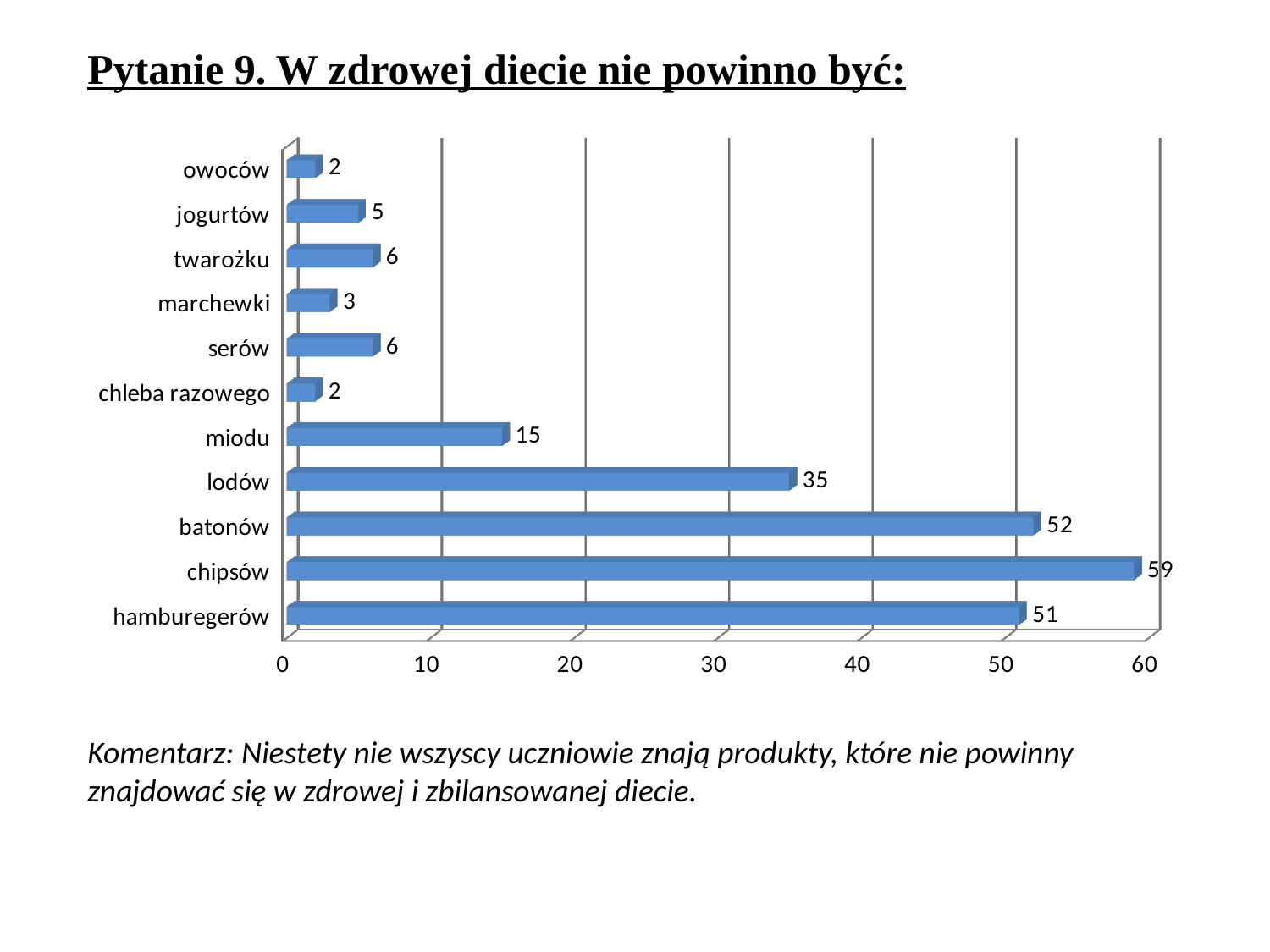
What is the difference between the values for batonów and hamburegerów? 1 Which is larger, the value for jogurtów or the value for marchewki? jogurtów What is the value for lodów? 35 What is the title of the slide above the chart? Pytanie 9. W zdrowej diecie nie powinno być: What kind of chart is shown on the slide? bar chart How many categories are shown in the chart? 11 What is the value for miodu? 15 What is the difference between the values for chipsów and lodów? 24 Which category has the highest value? chipsów Which categories share the lowest value of 2? owoców and chleba razowego What is the value for chipsów? 59 Is the value for lodów greater or less than 30? greater